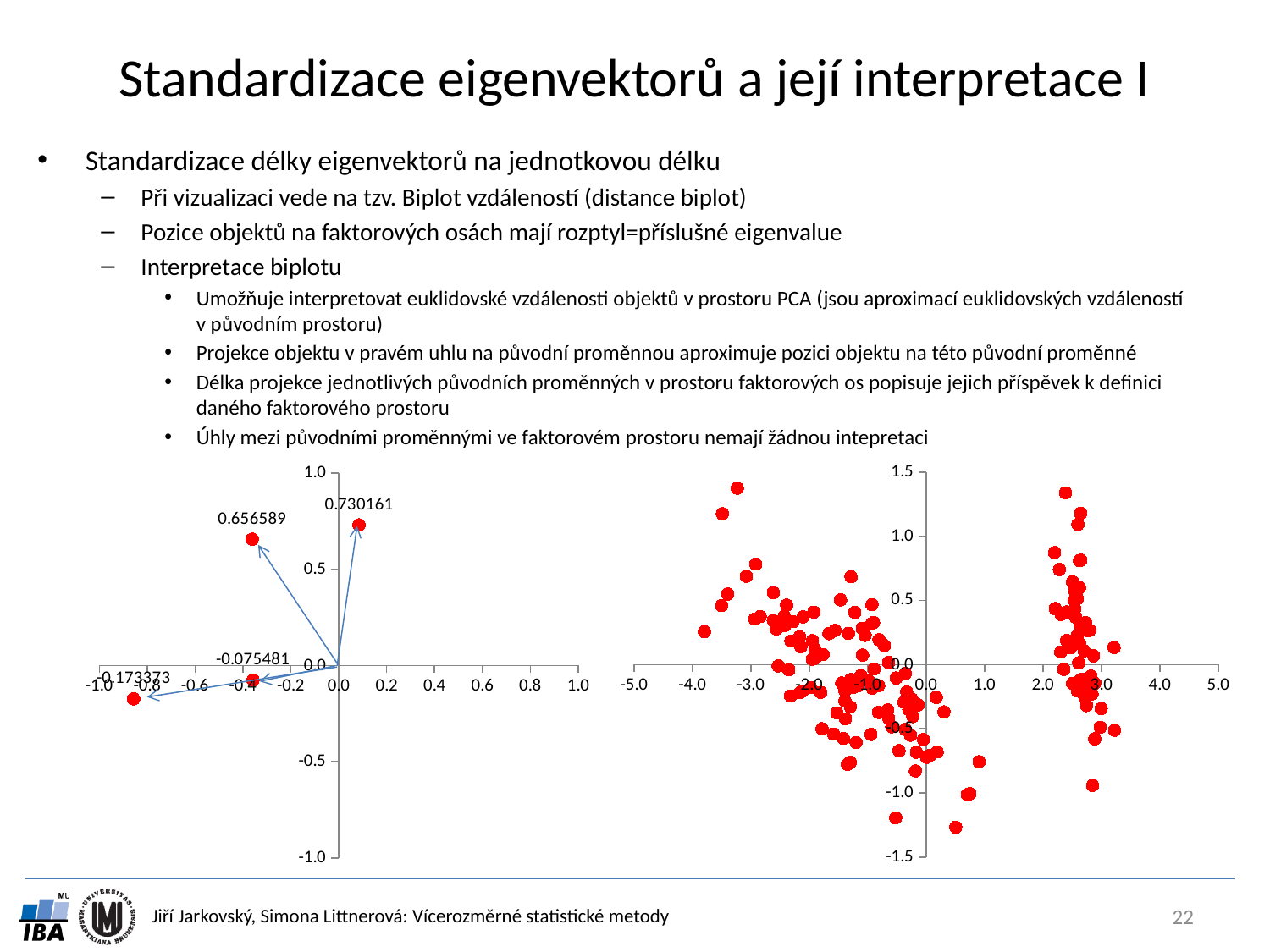
In the left chart, what is the difference between the labelled values 0.730161 and 0.656589? 0.073572 In the left chart, what is the smallest labelled value? -0.173373 What kind of chart is the left chart on the slide? scatter chart In the left chart, is the y value of the point labelled 0.730161 greater or less than 0.5? greater In the left chart, how many data points have printed data labels? 4 In the right chart, what is the maximum value shown on the y axis? 1.5 In the right chart, what is the maximum value shown on the x axis? 5.0 In the left chart, what is the largest labelled value? 0.730161 In the left chart, is the x value of the point labelled -0.173373 greater or less than -0.5? less In the left chart, which labelled value is larger: 0.656589 or 0.730161? 0.730161 In the left chart, how many arrows are drawn from the origin? 4 What kind of chart is the right chart on the slide? scatter chart